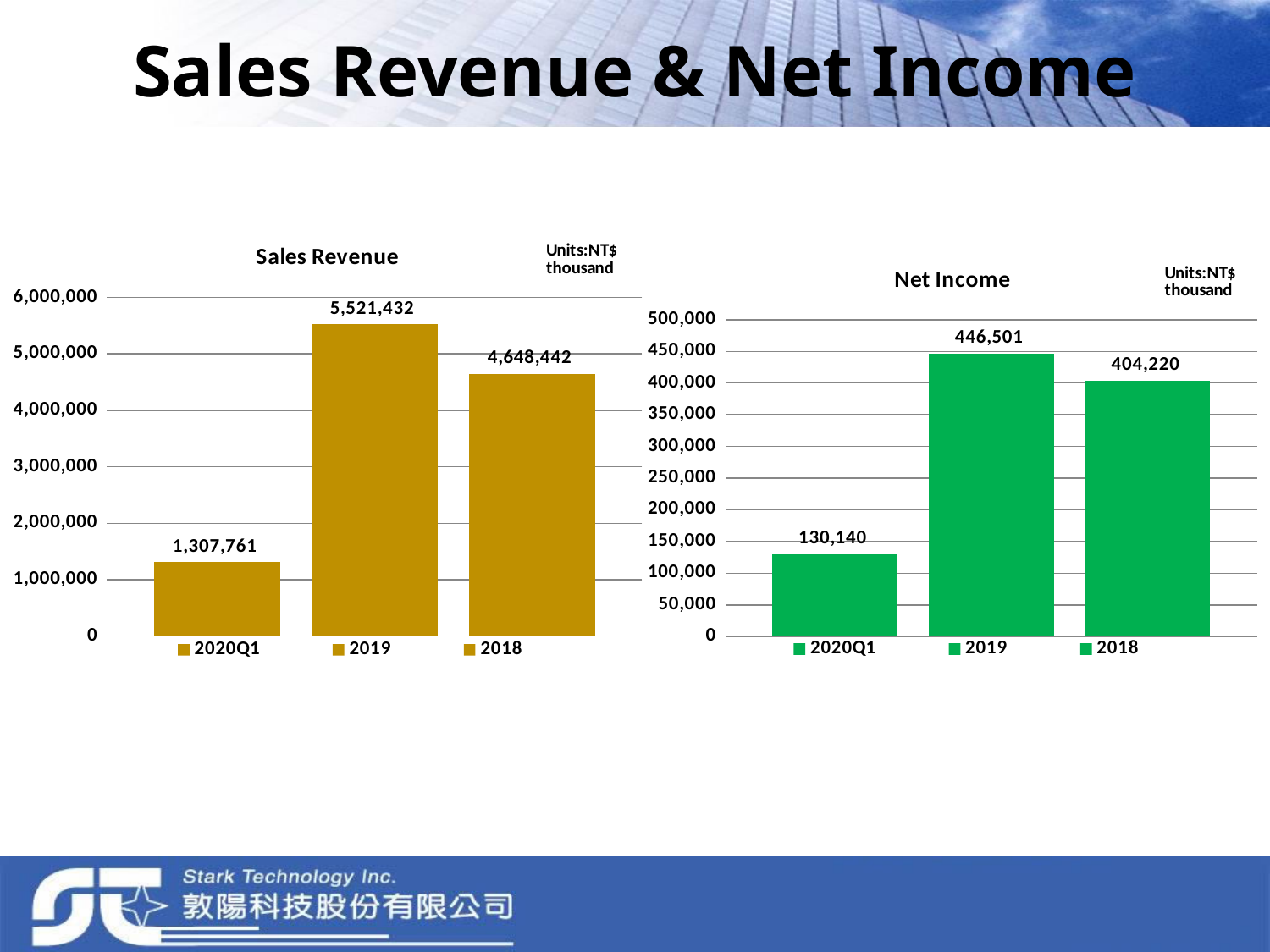
In the Sales Revenue chart, what is the difference between the 2019 and 2018 values? 872,990 In the Net Income chart, what is the difference between the 2019 and 2018 values? 42,281 In the Net Income chart, which is larger, the value for 2019 or the value for 2018? 2019 In the Sales Revenue chart, what is the value for 2019? 5,521,432 What units are stated for the Sales Revenue chart? NT$ thousand In the Net Income chart, what is the value for 2018? 404,220 What kind of chart is the Net Income chart? Bar chart In the Sales Revenue chart, which category has the highest value? 2019 In the Sales Revenue chart, what is the value for 2020Q1? 1,307,761 In the Net Income chart, what is the value for 2020Q1? 130,140 How many bars are plotted in the Sales Revenue chart? 3 In the Net Income chart, which category has the lowest value? 2020Q1